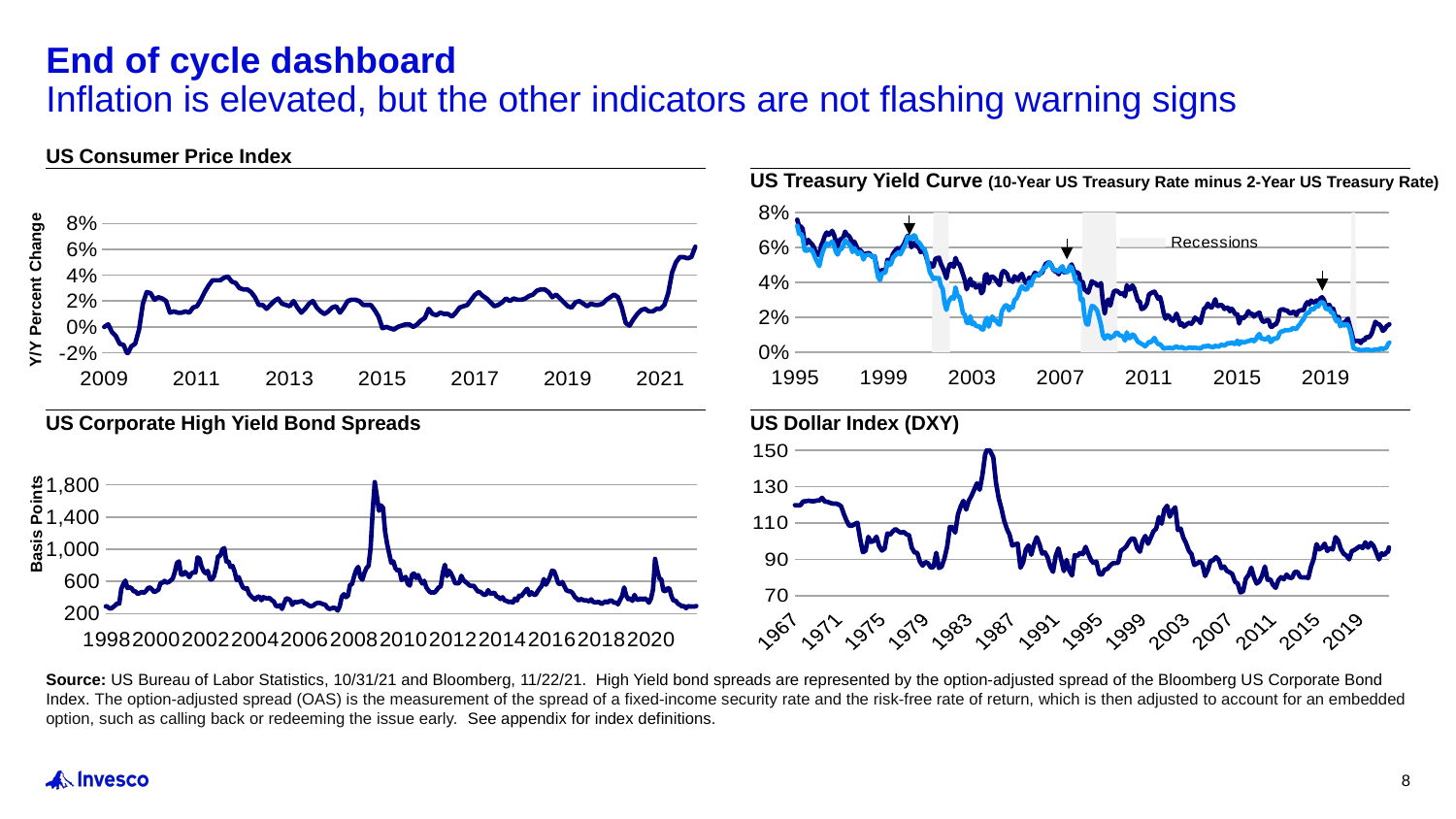
On the US Consumer Price Index chart, is the lowest value around 2009 greater or less than 0%? less What kind of chart is the US Dollar Index (DXY) chart? line chart How many charts are shown on the slide? 4 What do the shaded grey areas on the US Treasury Yield Curve chart represent? Recessions On the US Treasury Yield Curve chart, is the value of the lighter blue line in 2013 greater or less than 2%? less On the US Corporate High Yield Bond Spreads chart, is the peak value around 2008 greater or less than 1,400 basis points? greater What is the y-axis label on the US Corporate High Yield Bond Spreads chart? Basis Points What kind of chart is the US Consumer Price Index chart? line chart On the US Dollar Index (DXY) chart, does the index rise or fall between 1979 and 1985? rise